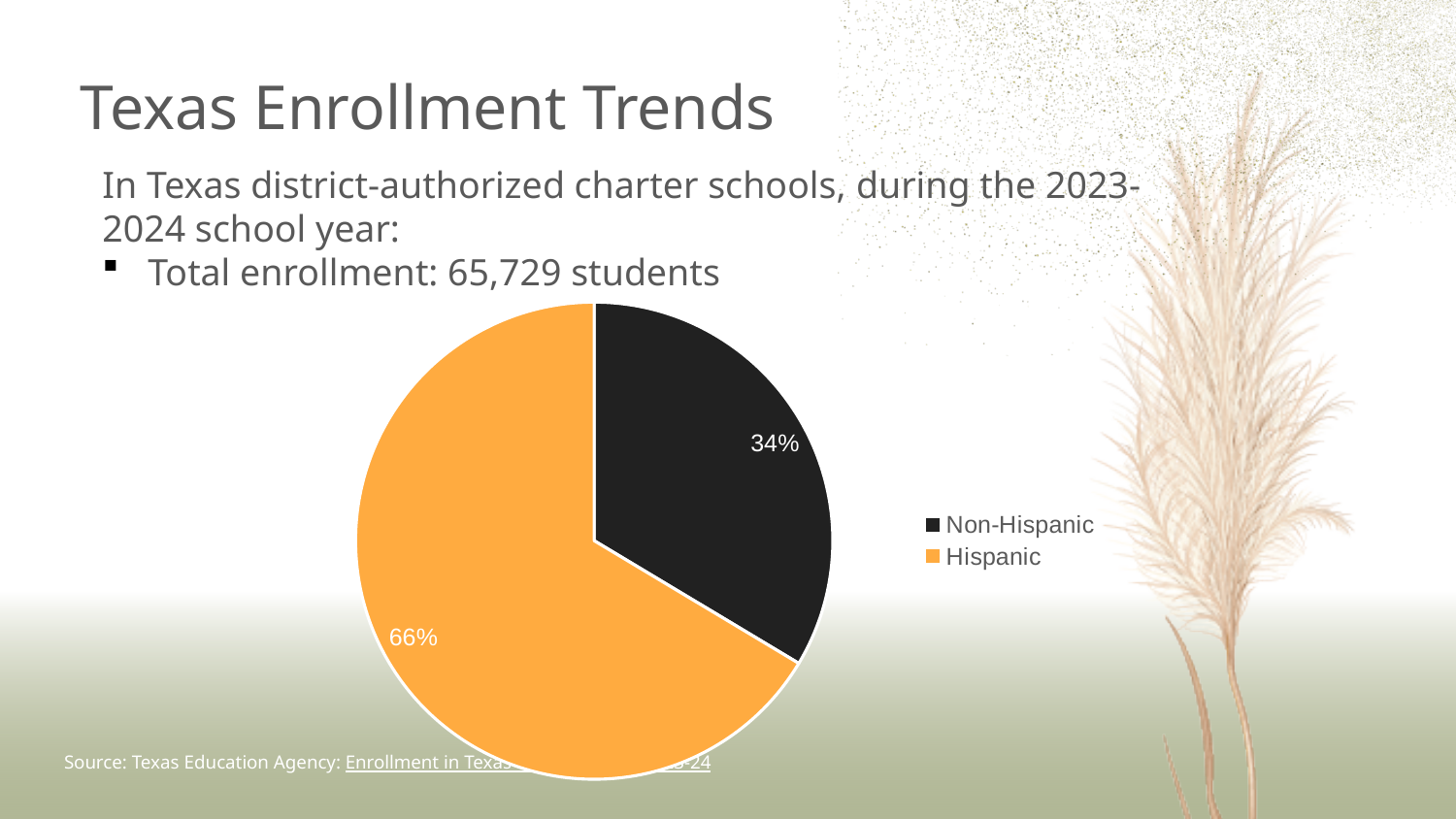
How many entries does the legend list? 2 What kind of chart is shown on the slide? pie chart Which slice of the pie is the smallest? Non-Hispanic What share of the pie does the Hispanic slice represent? 66% Which slice of the pie is the largest? Hispanic What colour is the Hispanic slice of the pie? orange Is the Non-Hispanic share greater or less than 50%? less What share of the pie does the Non-Hispanic slice represent? 34% What colour is the Non-Hispanic slice of the pie? black What is the difference in percentage points between the Hispanic and Non-Hispanic slices? 32 How many slices does the pie chart have? 2 Which is larger, the Hispanic slice or the Non-Hispanic slice? Hispanic